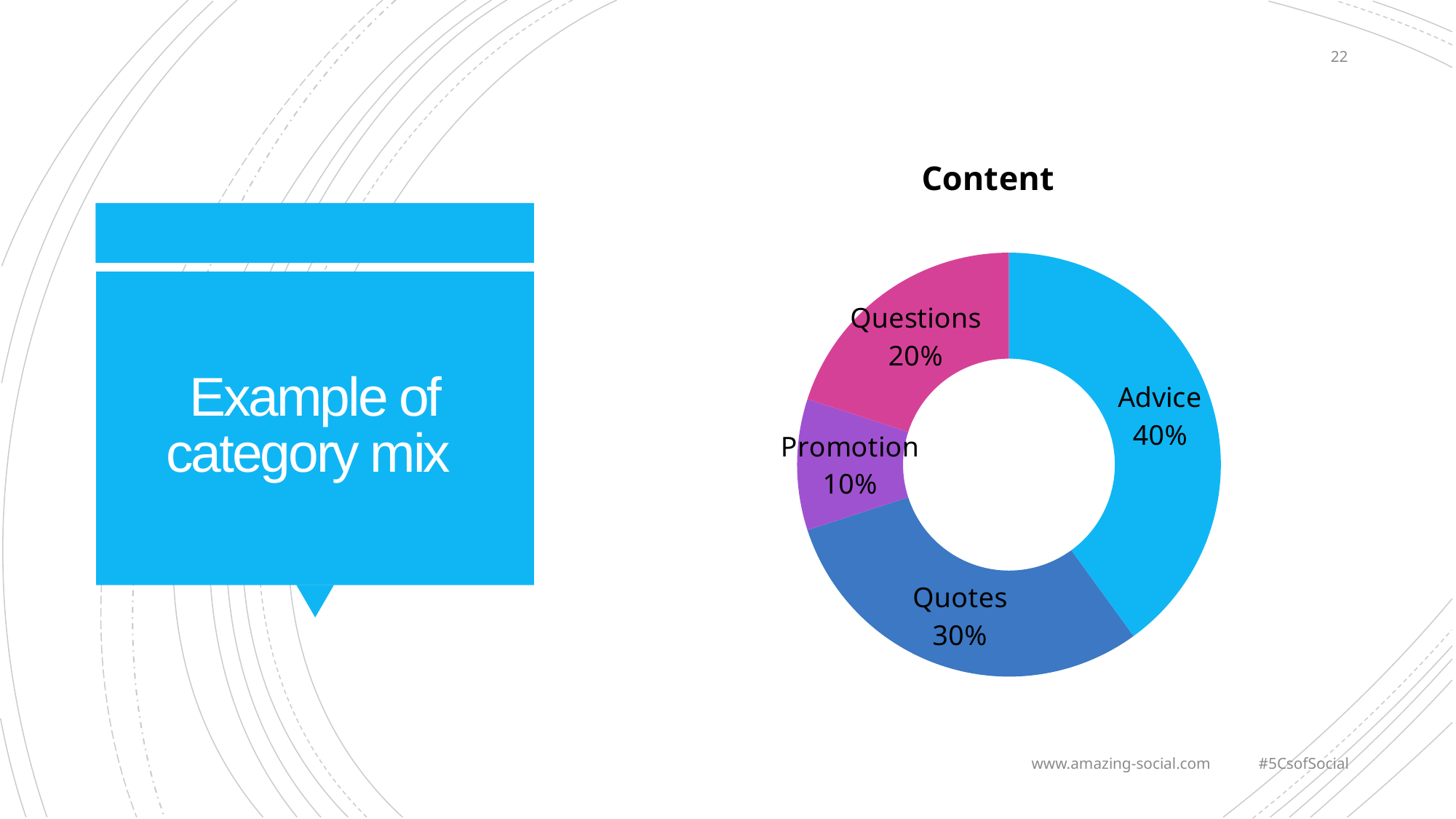
What kind of chart is the Content chart? Doughnut chart What is the title of the chart on the slide? Content Which is larger in the Content chart, Quotes or Questions? Quotes How many categories are shown in the Content chart? 4 What is the difference between the Advice and Quotes shares in the Content chart? 10% What is the difference between the Questions and Promotion shares in the Content chart? 10% What share of the Content chart is Quotes? 30% Which category has the largest share in the Content chart? Advice What share of the Content chart is Advice? 40% Which category has the smallest share in the Content chart? Promotion What share of the Content chart is Promotion? 10% What share of the Content chart is Questions? 20%